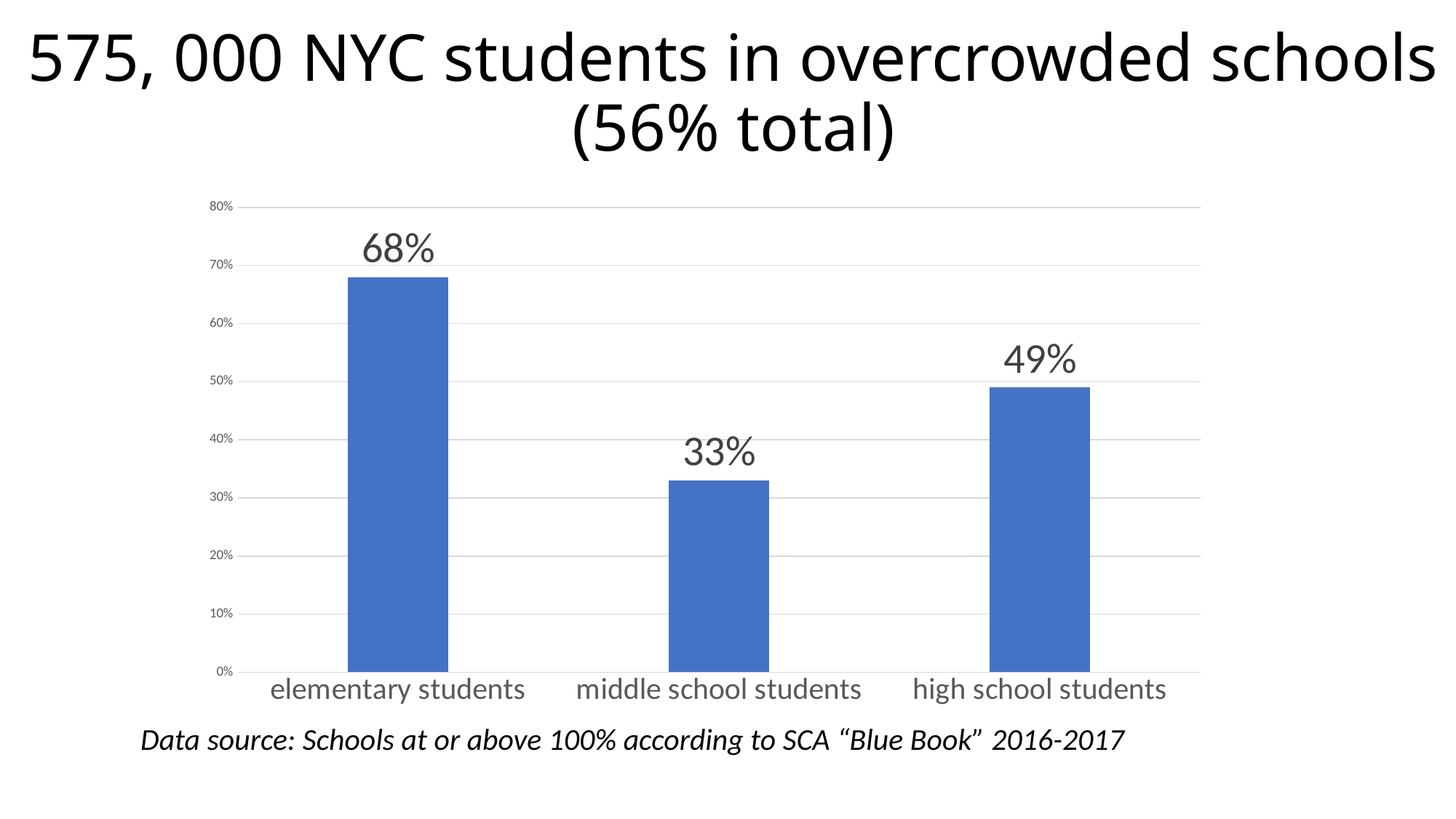
What is the difference in percentage points between high school students and middle school students? 16 percentage points Which category has the lowest percentage of students in overcrowded schools? middle school students Which category has the highest percentage of students in overcrowded schools? elementary students What kind of chart is shown on the slide? bar chart What percentage of middle school students are in overcrowded schools? 33% What percentage of elementary students are in overcrowded schools? 68% What percentage of high school students are in overcrowded schools? 49% What is the difference in percentage points between elementary students and middle school students? 35 percentage points Which is larger, the value for high school students or the value for middle school students? high school students What is the title of the slide? 575, 000 NYC students in overcrowded schools (56% total) How many categories are shown on the chart? 3 Is the value for high school students greater or less than 50%? less